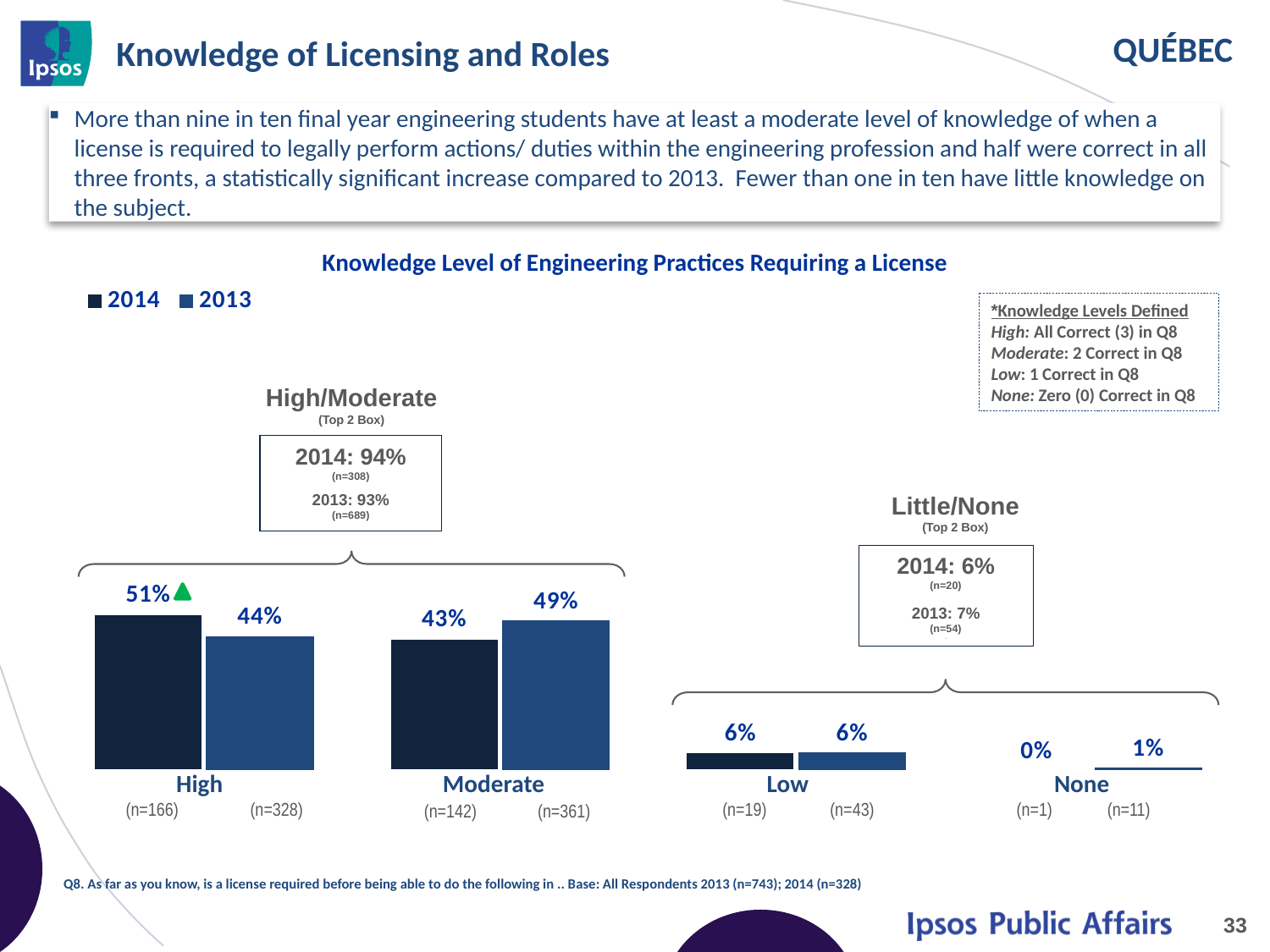
What is the title of the chart? Knowledge Level of Engineering Practices Requiring a License What is the 2013 value for Moderate? 49% How many categories are shown on the x axis? 4 Which category has the highest 2014 value? High What is the difference between the 2014 and 2013 values for High? 7% Which is larger for Moderate, the 2014 value or the 2013 value? 2013 What is the 2013 value for None? 1% What is the 2014 value for High? 51% How many series does the legend list? 2 What kind of chart is this? Bar chart Which category has the lowest 2013 value? None What is the difference between the 2013 and 2014 values for Moderate? 6%